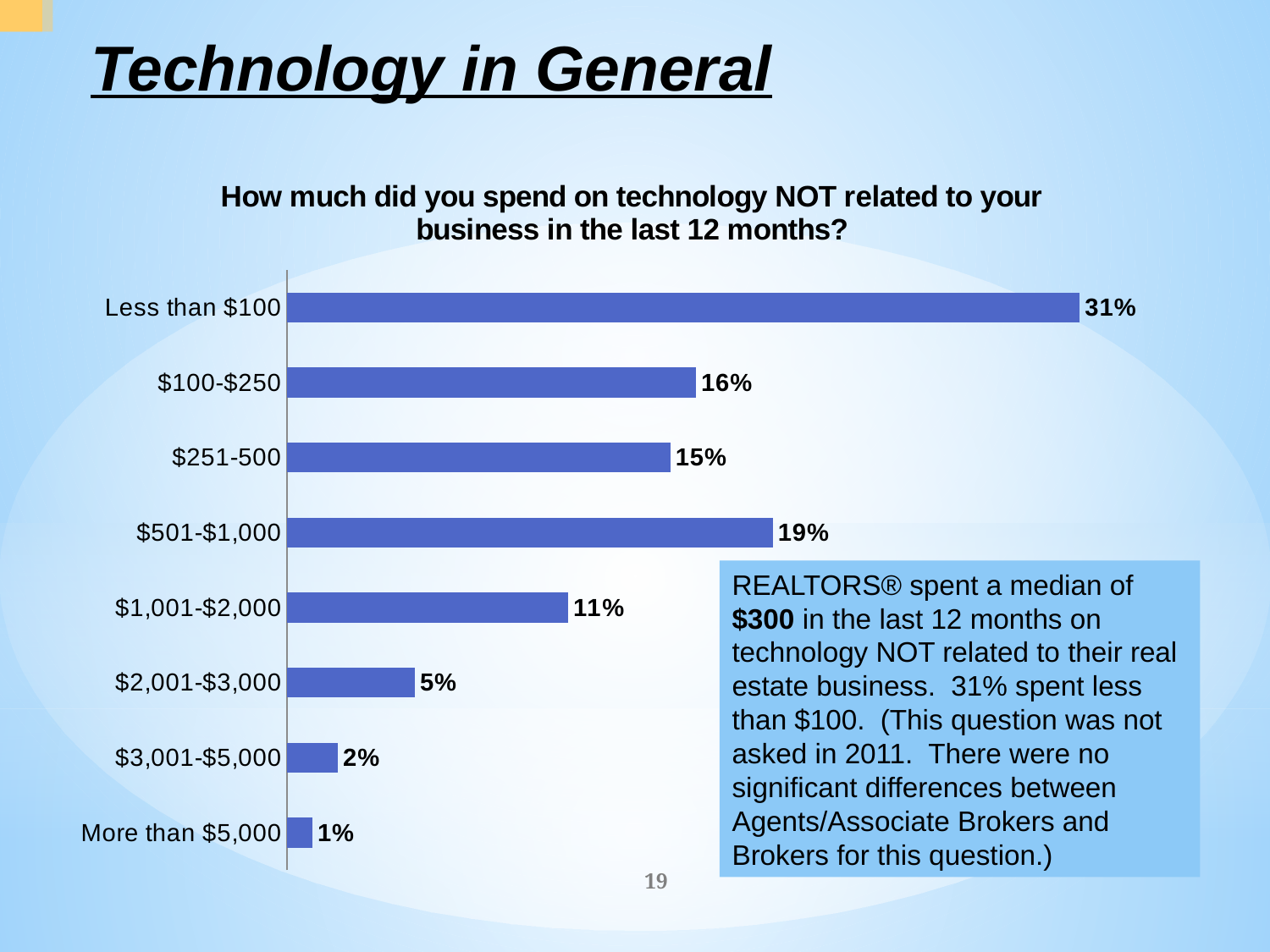
What is the value for the $501-$1,000 category? 19% Which spending category has the highest percentage? Less than $100 How many spending categories are shown in the chart? 8 What is the difference between the $100-$250 and $251-500 categories? 1% What is the title of the chart? How much did you spend on technology NOT related to your business in the last 12 months? What percentage spent $2,001-$3,000? 5% Which spending category has the lowest percentage? More than $5,000 Which is larger, the value for $501-$1,000 or the value for $100-$250? $501-$1,000 How much larger is the Less than $100 value than the $1,001-$2,000 value? 20% What is the combined percentage for the $3,001-$5,000 and More than $5,000 categories? 3% What kind of chart is shown on the slide? Bar chart What percentage of respondents spent less than $100 on technology not related to their business? 31%